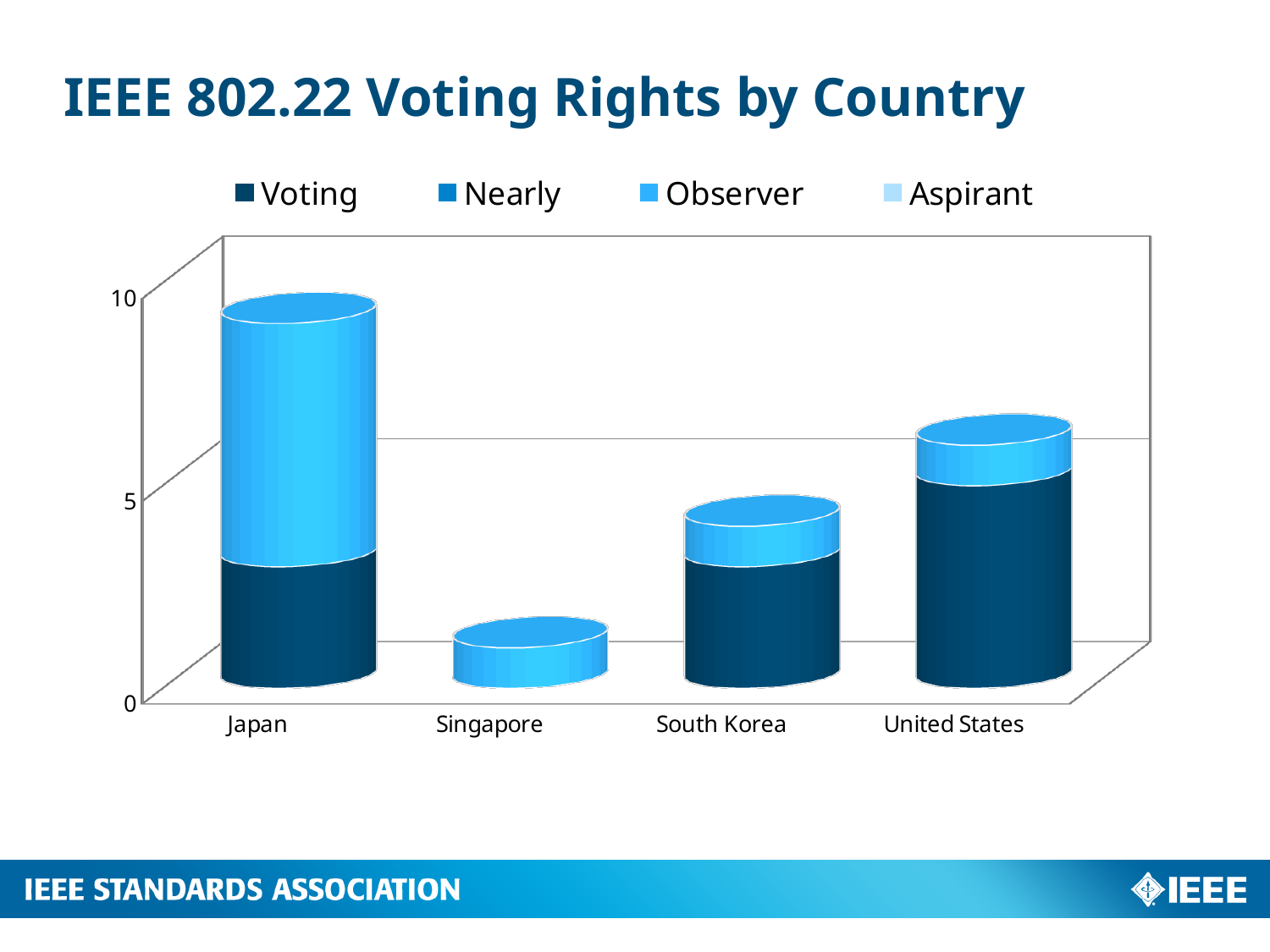
Is the Voting value for Japan greater or less than 5? less Which country has the tallest stacked bar in the chart? Japan Is the total stacked value for Japan greater or less than 5? greater Which country has the shortest stacked bar in the chart? Singapore Is the total stacked value for United States greater or less than 10? less Which has the larger total stacked bar, Japan or United States? Japan What kind of chart is shown on the slide? bar chart How many countries are shown on the x axis of the chart? 4 What is the title of the chart on the slide? IEEE 802.22 Voting Rights by Country How many series does the chart legend list? 4 Which has the larger Voting segment, Japan or United States? United States